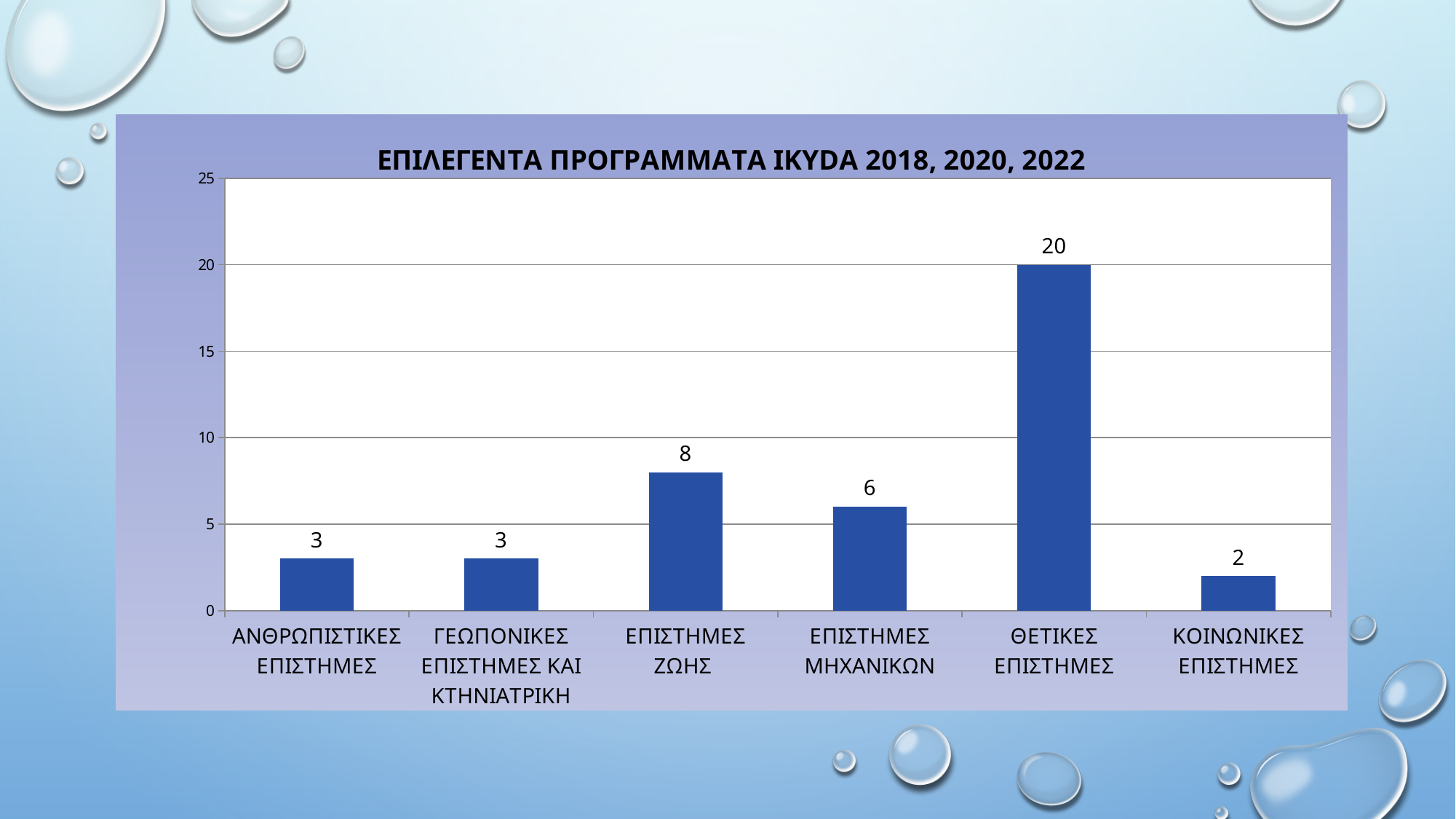
What is the value for ΕΠΙΣΤΗΜΕΣ ΜΗΧΑΝΙΚΩΝ? 6 Which category has the lowest value? ΚΟΙΝΩΝΙΚΕΣ ΕΠΙΣΤΗΜΕΣ What is the value for ΕΠΙΣΤΗΜΕΣ ΖΩΗΣ? 8 What is the title of the chart? ΕΠΙΛΕΓΕΝΤΑ ΠΡΟΓΡΑΜΜΑΤΑ IKYDA 2018, 2020, 2022 Is the value for ΘΕΤΙΚΕΣ ΕΠΙΣΤΗΜΕΣ greater or less than 15? greater What kind of chart is shown on the slide? bar chart Which category has the highest value? ΘΕΤΙΚΕΣ ΕΠΙΣΤΗΜΕΣ How many categories are shown on the x axis? 6 Which is larger, the value for ΕΠΙΣΤΗΜΕΣ ΖΩΗΣ or the value for ΕΠΙΣΤΗΜΕΣ ΜΗΧΑΝΙΚΩΝ? ΕΠΙΣΤΗΜΕΣ ΖΩΗΣ What is the difference between the values for ΘΕΤΙΚΕΣ ΕΠΙΣΤΗΜΕΣ and ΕΠΙΣΤΗΜΕΣ ΖΩΗΣ? 12 What is the value for ΘΕΤΙΚΕΣ ΕΠΙΣΤΗΜΕΣ? 20 What is the value for ΚΟΙΝΩΝΙΚΕΣ ΕΠΙΣΤΗΜΕΣ? 2